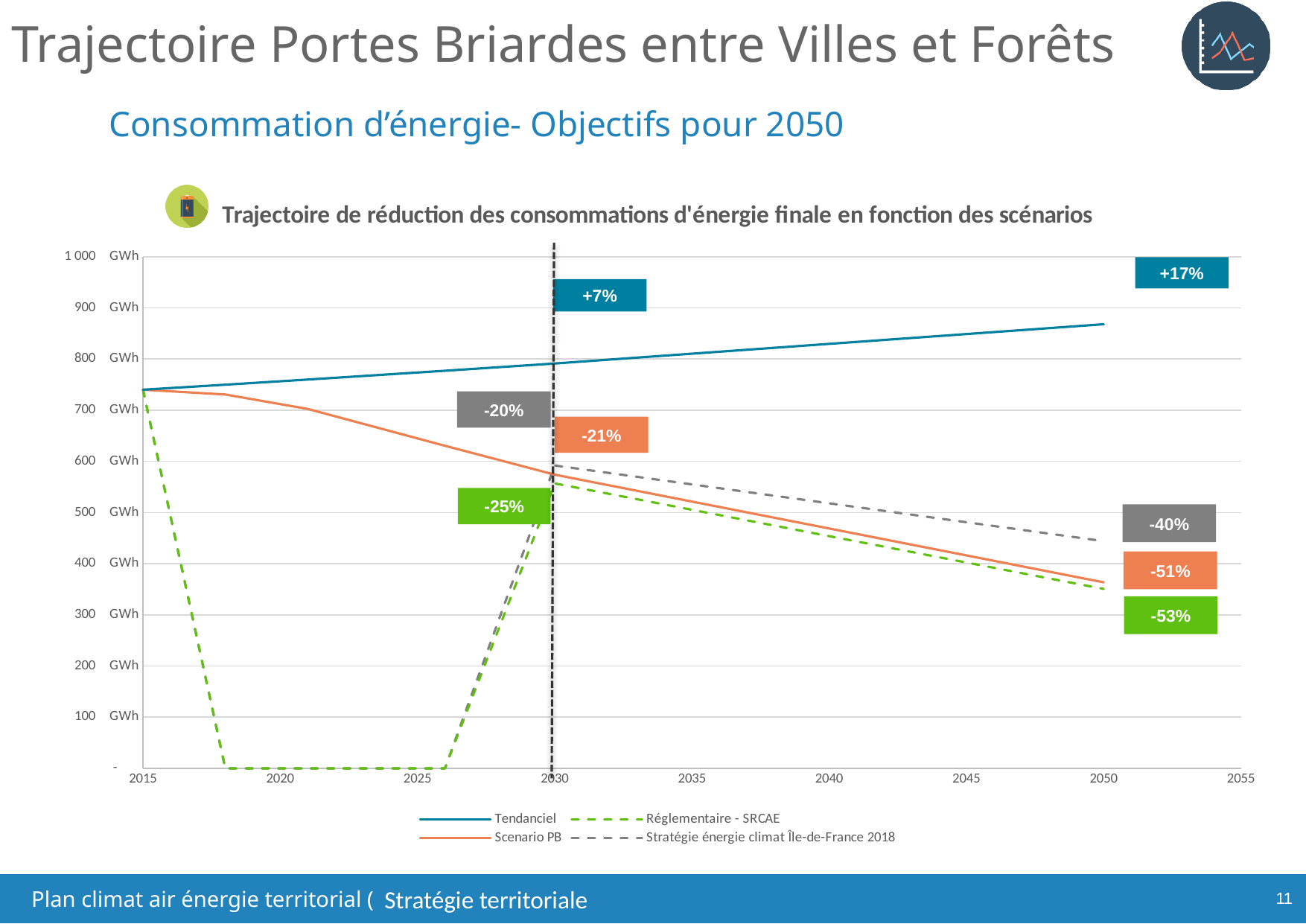
What percentage label is shown for the Scenario PB at 2050? -51% What percentage label is shown for the Réglementaire - SRCAE scenario at 2050? -53% What kind of chart is shown on the slide? line chart What percentage label is shown for the Stratégie énergie climat Île-de-France 2018 scenario at 2030? -20% What is the difference in percentage points between the 2050 labels for Stratégie énergie climat Île-de-France 2018 (-40%) and Scenario PB (-51%)? 11 percentage points Which series has the highest value in 2050? Tendanciel How many series does the legend of the chart list? 4 What percentage label is shown for the Tendanciel scenario at 2050? +17% Does the Tendanciel line rise or fall between 2015 and 2050? rises Is the Tendanciel value in 2050 greater or less than 800 GWh? greater What percentage label is shown for the Tendanciel scenario at 2030? +7% Is the Scenario PB value in 2050 greater or less than 400 GWh? less